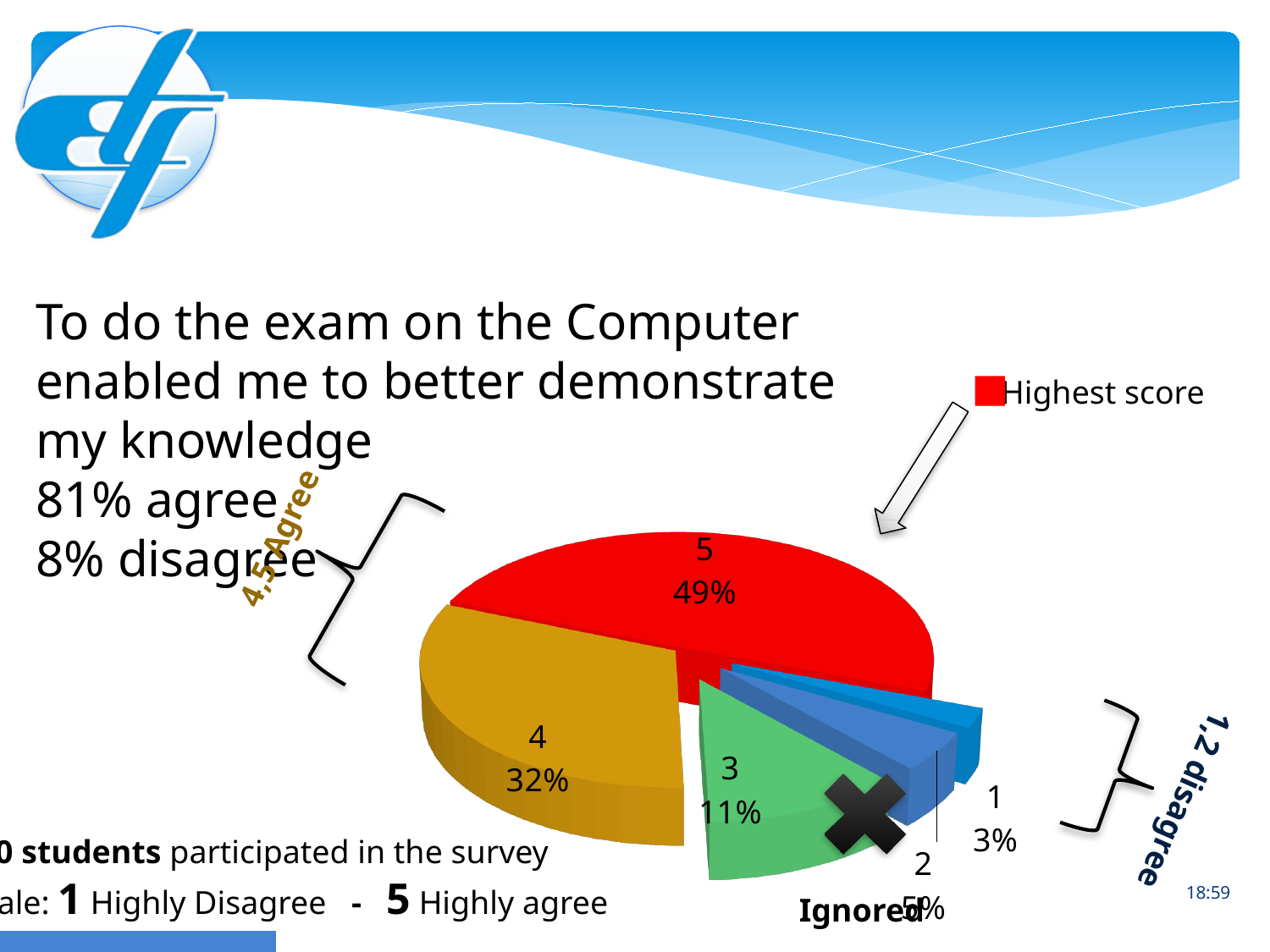
What percentage of the pie does the slice labelled 1 represent? 3% What percentage of the pie does the slice labelled 5 represent? 49% Which slice of the pie chart is the largest? 5 What kind of chart is shown on the slide? pie chart Which slice is larger, the one labelled 4 or the one labelled 3? 4 Which slice of the pie chart is the smallest? 1 What is the combined share of the slices labelled 4 and 5? 81% What colour is the slice labelled 5 in the pie chart? red How many slices does the pie chart have? 5 What is the difference in percentage points between the slice labelled 5 and the slice labelled 4? 17% What percentage of the pie does the slice labelled 3 represent? 11% What percentage of the pie does the slice labelled 4 represent? 32%